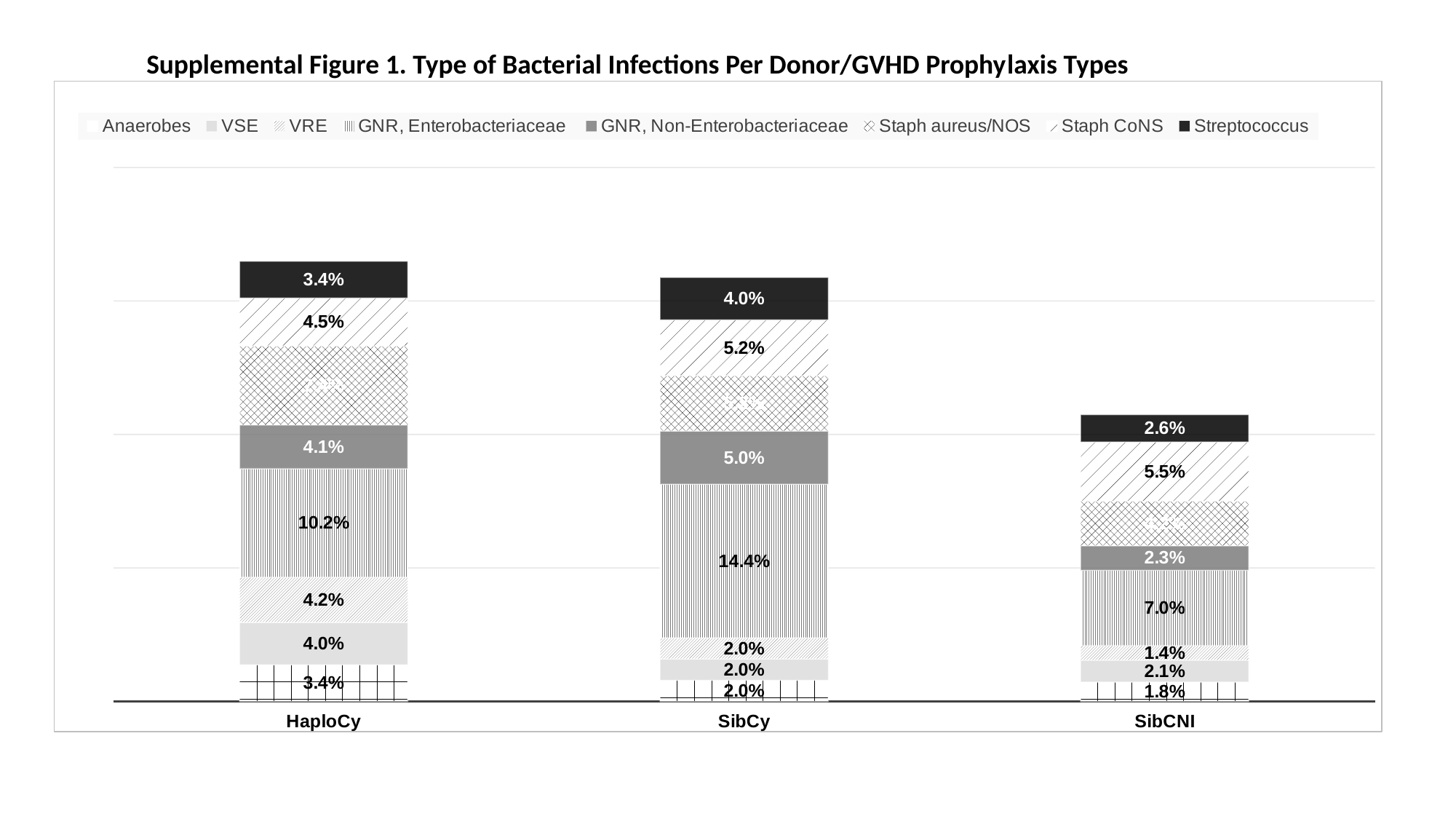
Which category has the highest value for GNR, Enterobacteriaceae? SibCy What kind of chart is shown on the slide? Stacked bar chart How many series does the legend list? 8 What is the value for GNR, Enterobacteriaceae in the SibCy bar? 14.4% What is the value for Streptococcus in the SibCNI bar? 2.6% How many donor/GVHD prophylaxis categories are shown on the x axis? 3 Which category has the lowest value for GNR, Non-Enterobacteriaceae? SibCNI What is the difference between the GNR, Enterobacteriaceae values for SibCy and HaploCy? 4.2% What is the value for Staph CoNS in the SibCNI bar? 5.5% Which is larger: the Streptococcus value for SibCy or for HaploCy? SibCy What is the title of the chart? Supplemental Figure 1. Type of Bacterial Infections Per Donor/GVHD Prophylaxis Types What is the value for VRE in the HaploCy bar? 4.2%